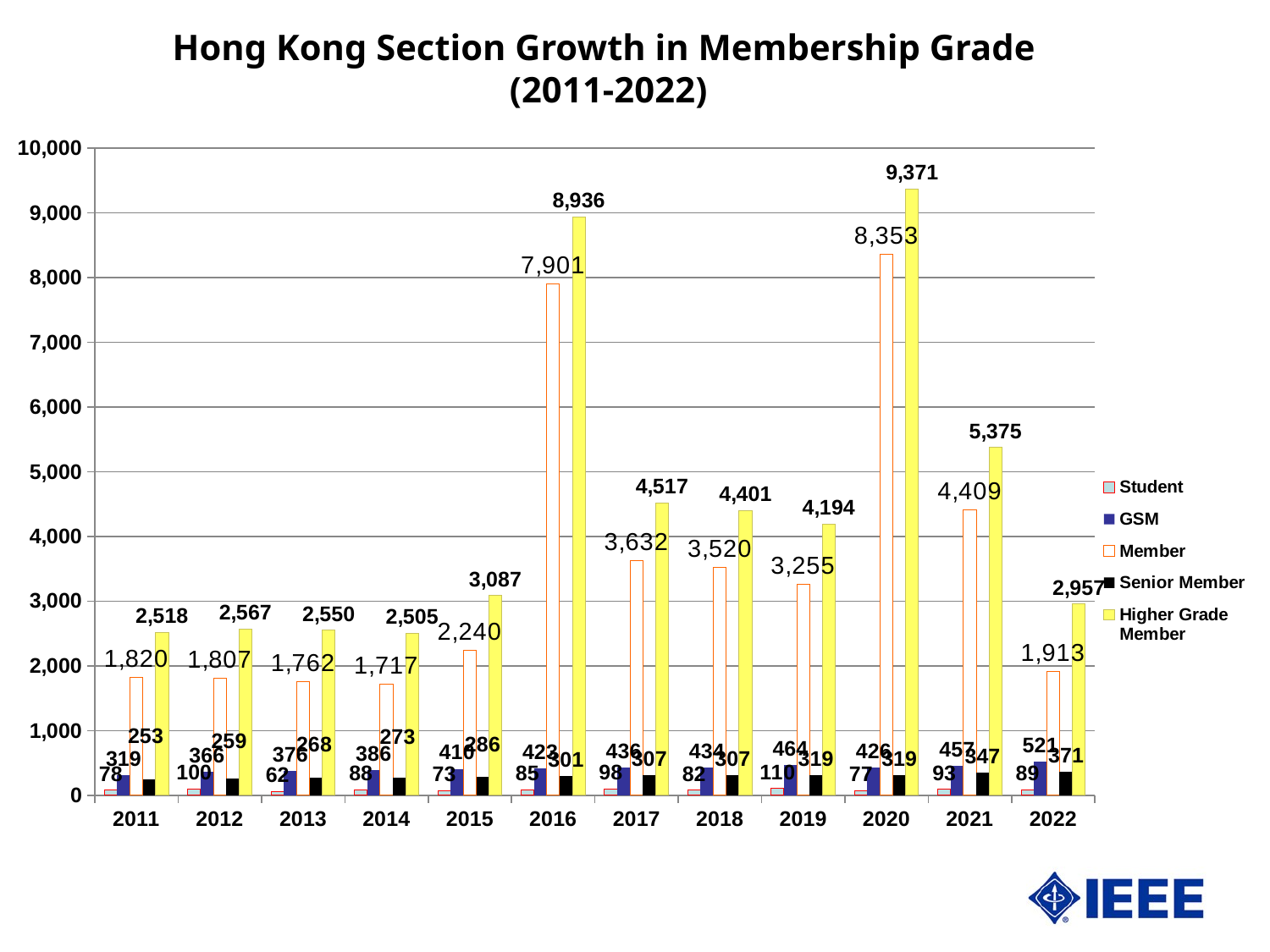
What is the difference between the Higher Grade Member values in 2020 and 2021? 3,996 What is the value for Member in 2016? 7,901 What is the value for Higher Grade Member in 2020? 9,371 How many series does the legend list? 5 What is the value for Student in 2019? 110 In which year is the Higher Grade Member value highest? 2020 What is the value for Senior Member in 2022? 371 Which is larger, the Member value in 2017 or in 2018? 2017 How many years are shown on the x axis? 12 What kind of chart is shown on the slide? Bar chart Which series is shown in yellow in the legend? Higher Grade Member In which year is the Member value lowest? 2014